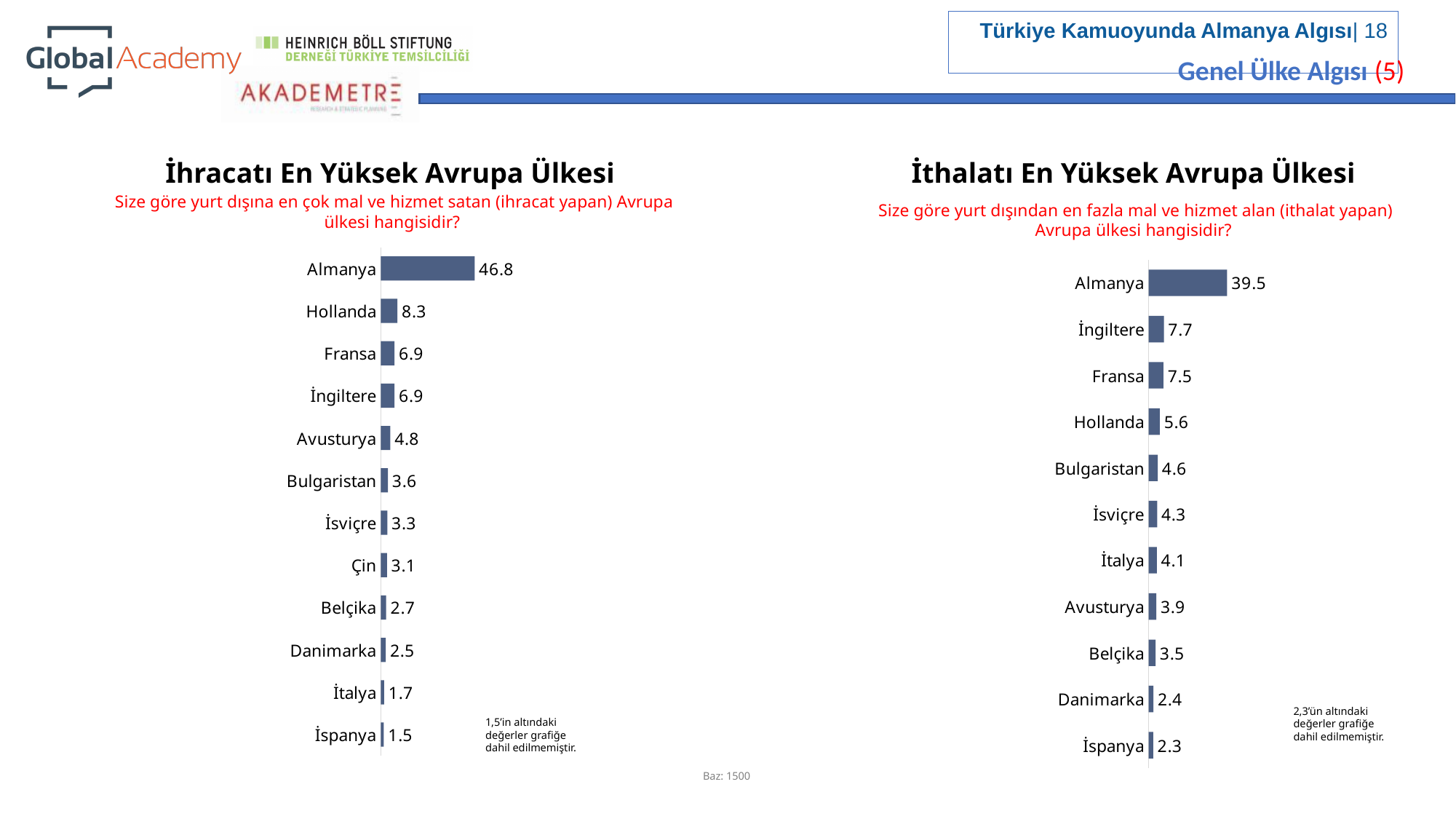
How many countries are shown in the 'İthalatı En Yüksek Avrupa Ülkesi' chart? 11 In the 'İhracatı En Yüksek Avrupa Ülkesi' chart, what is the difference between Almanya and Hollanda? 38.5 What kind of chart is the 'İthalatı En Yüksek Avrupa Ülkesi' chart? Bar chart In the 'İthalatı En Yüksek Avrupa Ülkesi' chart, what is the difference between Fransa and Hollanda? 1.9 In the 'İthalatı En Yüksek Avrupa Ülkesi' chart, what is the value for İngiltere? 7.7 How many countries are shown in the 'İhracatı En Yüksek Avrupa Ülkesi' chart? 12 In the 'İhracatı En Yüksek Avrupa Ülkesi' chart, what is the value for Almanya? 46.8 In the 'İthalatı En Yüksek Avrupa Ülkesi' chart, which country has the highest value? Almanya In the 'İthalatı En Yüksek Avrupa Ülkesi' chart, which is larger, the value for Belçika or the value for İsviçre? İsviçre In the 'İhracatı En Yüksek Avrupa Ülkesi' chart, which is larger, the value for Avusturya or the value for Bulgaristan? Avusturya In the 'İhracatı En Yüksek Avrupa Ülkesi' chart, what is the value for Çin? 3.1 In the 'İhracatı En Yüksek Avrupa Ülkesi' chart, which country has the lowest value? İspanya